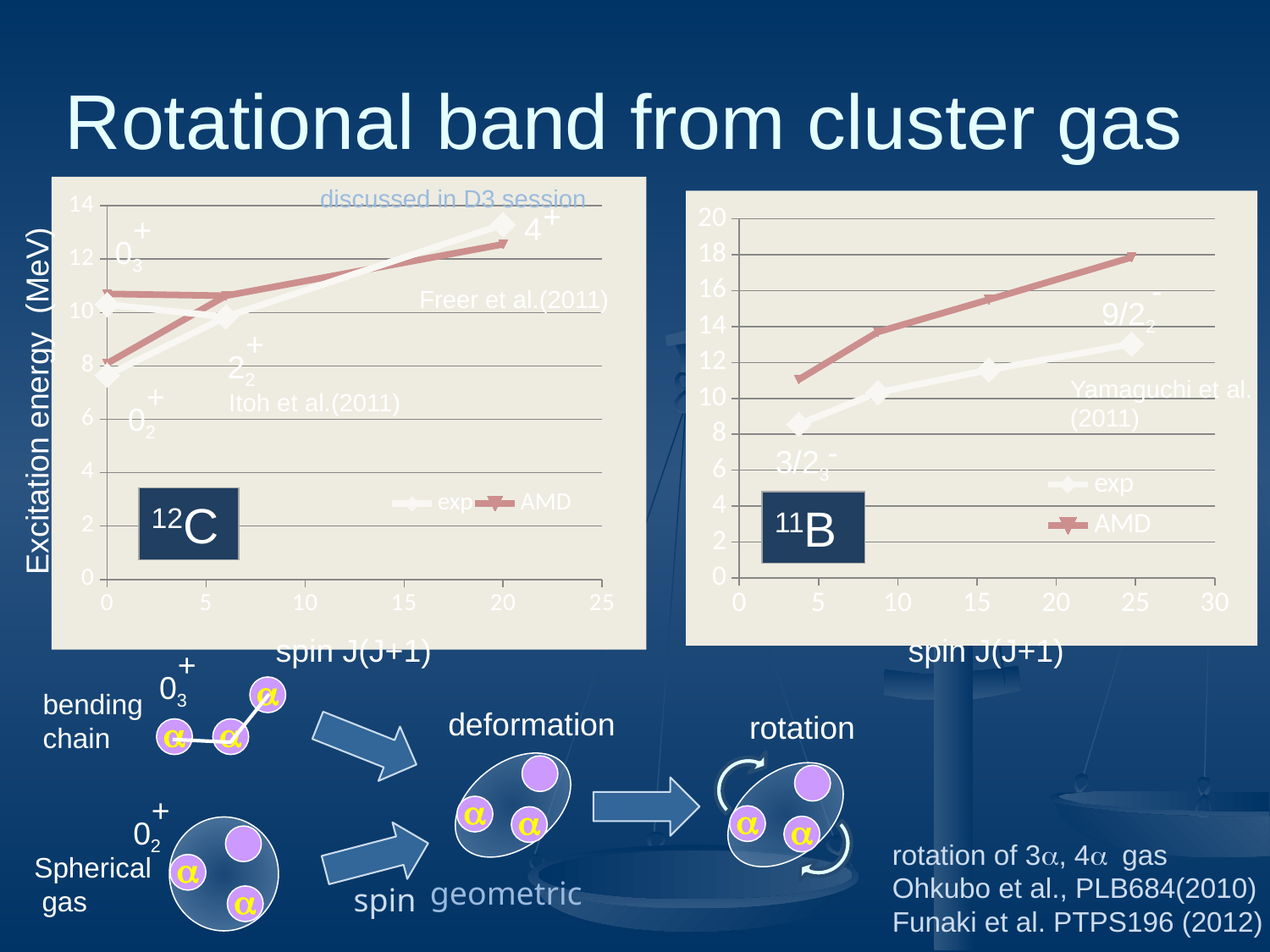
What is the y-axis label of the 12C chart on the left? Excitation energy (MeV) How many series does the legend of the 11B chart on the right list? 2 In the 11B chart on the right, do the exp values rise or fall as spin J(J+1) increases? rise In the 11B chart on the right, is the lowest exp value greater or less than 10? less What are the two series named in the legend of the 12C chart on the left? exp and AMD In the 12C chart on the left, is the exp value at spin J(J+1) = 20 greater or less than 12? greater In the 12C chart on the left, at spin J(J+1) = 0, which series has the larger value, exp or AMD? AMD In the 11B chart on the right, how many data points does the AMD series have? 4 In the 11B chart on the right, is the highest AMD value greater or less than 16? greater What kind of chart is the 12C chart on the left? line chart